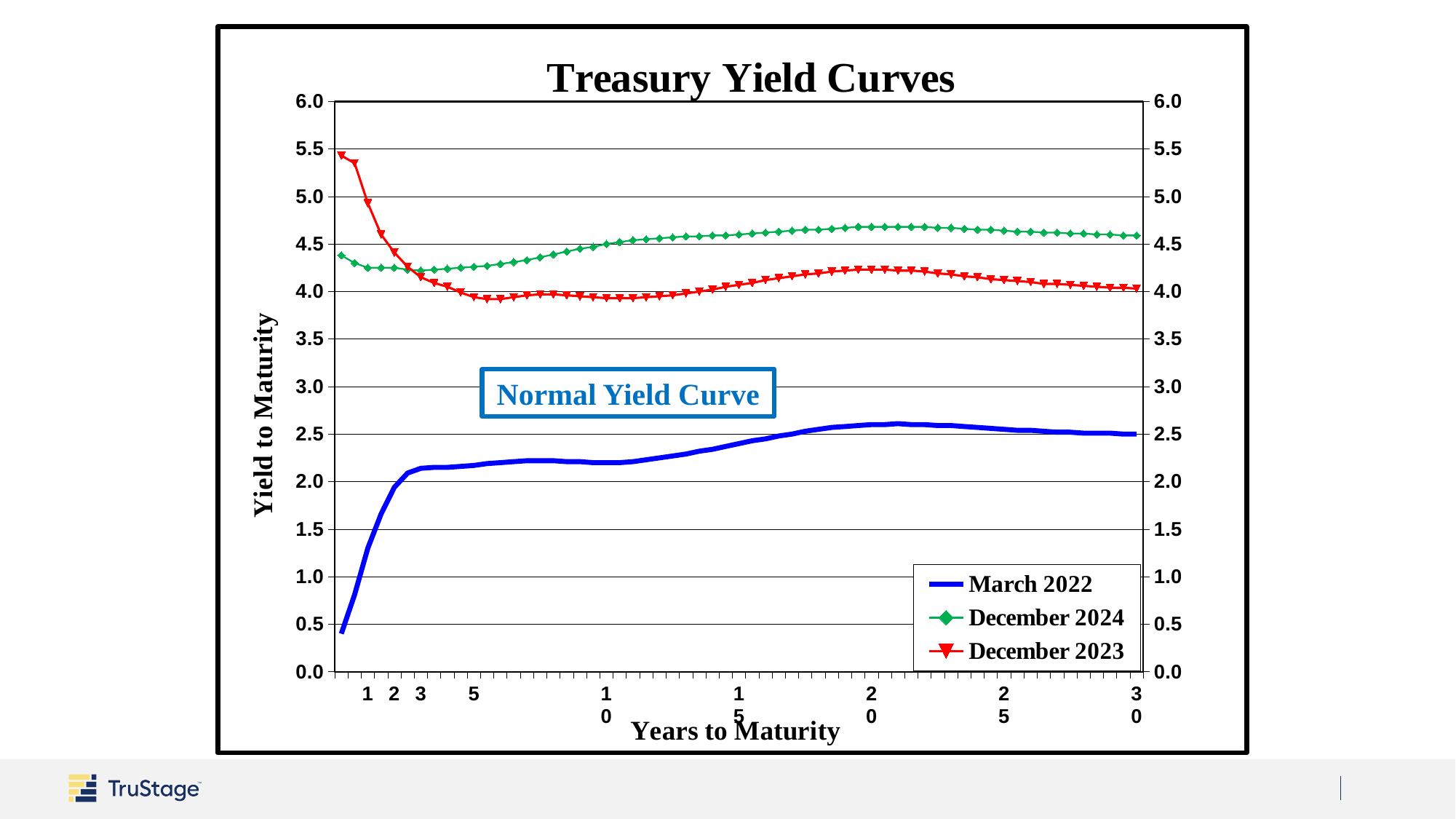
Is the March 2022 yield at 10 years to maturity greater or less than 2.5? less Does the December 2023 yield rise or fall between 1 and 5 years to maturity? fall Is the December 2024 yield at 30 years to maturity greater or less than 4.5? greater At 1 year to maturity, which is higher: December 2023 or December 2024? December 2023 What kind of chart is shown on the slide? line chart Which series has the lowest yields across all maturities? March 2022 Which series has the highest yield at 30 years to maturity? December 2024 What text appears in the boxed annotation inside the chart? Normal Yield Curve What is the title of the chart? Treasury Yield Curves Is the December 2023 yield at 20 years to maturity greater or less than 4.0? greater How many series does the legend list? 3 At 30 years to maturity, which is higher: December 2023 or December 2024? December 2024